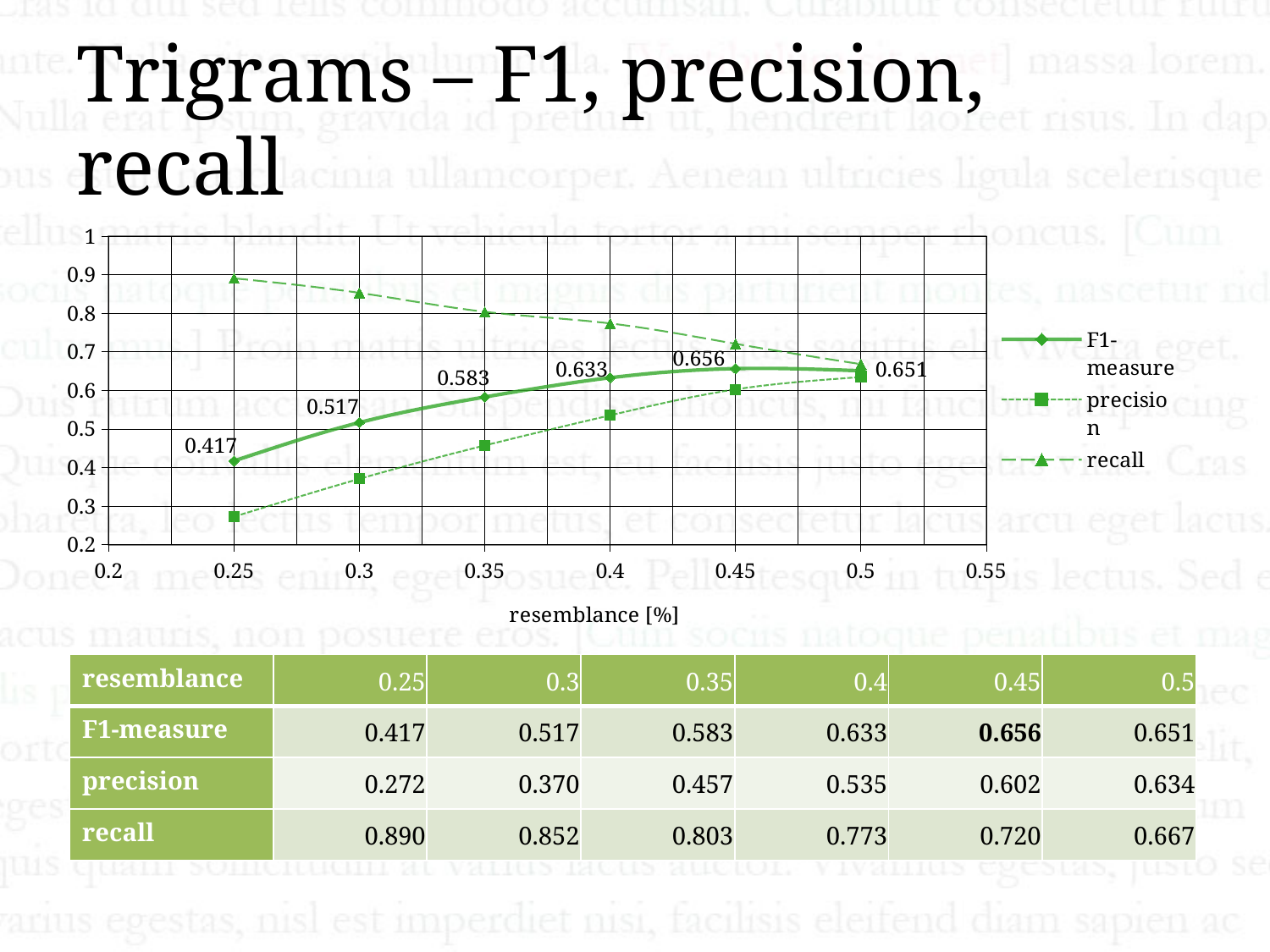
What is the recall value at resemblance 0.25? 0.890 What is the difference between the F1-measure at resemblance 0.45 and at resemblance 0.25? 0.239 Does recall rise or fall as resemblance increases along the x axis? fall At which resemblance value is the F1-measure highest? 0.45 What is the F1-measure value at resemblance 0.25? 0.417 At which resemblance value is precision lowest? 0.25 What is the F1-measure value at resemblance 0.35? 0.583 Which is larger at resemblance 0.3: recall or precision? recall What is the label of the x axis of the chart? resemblance [%] How many series does the chart legend list? 3 What kind of chart is shown on the slide? line chart What is the precision value at resemblance 0.5? 0.634